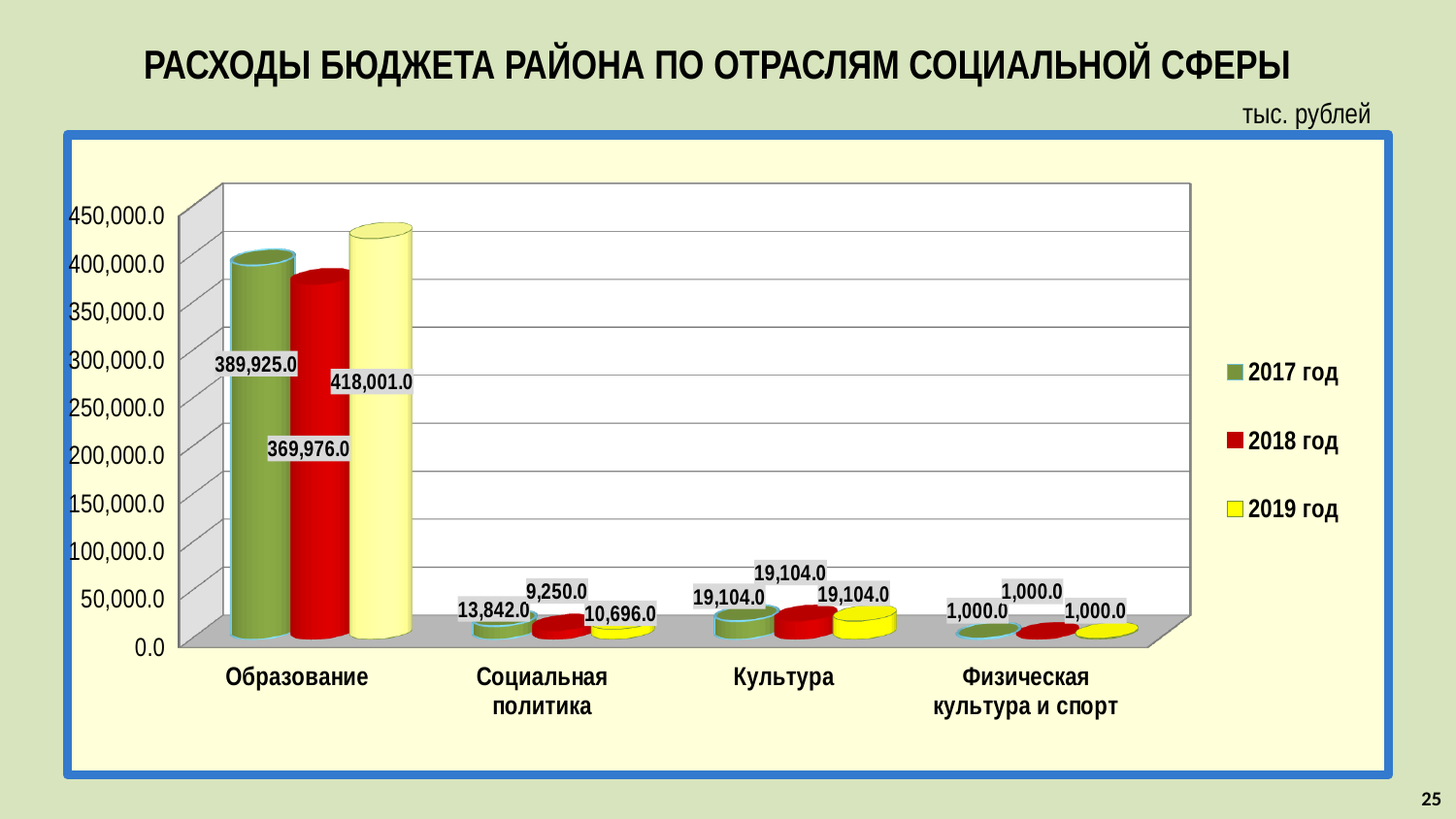
What is the value for Образование in 2019 год? 418,001.0 Which category has the lowest value in 2017 год? Физическая культура и спорт What is the difference between the 2019 год and 2018 год values for Образование? 48,025.0 How many categories are shown on the x axis? 4 Which category has the highest value in 2018 год? Образование What kind of chart is shown on the slide? Bar chart Is the value for Образование in 2017 год greater or less than 350,000.0? greater What is the value for Культура in 2017 год? 19,104.0 Which is larger for Социальная политика: the 2017 год value or the 2019 год value? 2017 год How many series does the legend list? 3 What is the value for Социальная политика in 2018 год? 9,250.0 What is the value for Физическая культура и спорт in 2019 год? 1,000.0